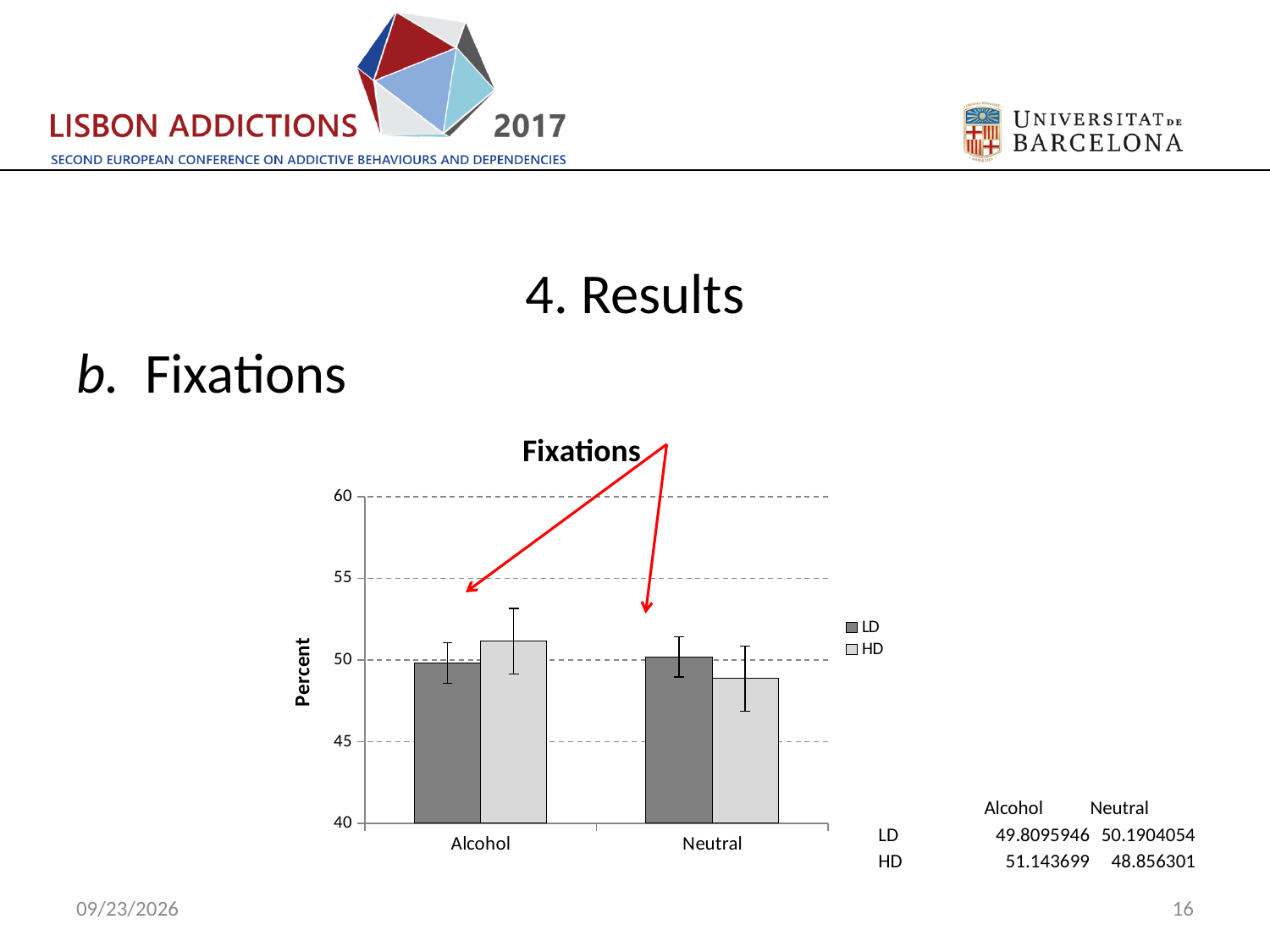
What is the LD value for Neutral in the Fixations chart? 50.1904054 What is the label of the y axis in the Fixations chart? Percent What is the HD value for Neutral in the Fixations chart? 48.856301 What kind of chart is shown under the title "Fixations"? bar chart Is the HD value for Neutral in the Fixations chart greater or less than 50? less What is the HD value for Alcohol in the Fixations chart? 51.143699 Is the HD value for Alcohol in the Fixations chart greater or less than 50? greater How many categories are shown on the x axis of the Fixations chart? 2 What is the LD value for Alcohol in the Fixations chart? 49.8095946 In the Fixations chart, which series has the higher value for Alcohol, LD or HD? HD In the Fixations chart, which series has the higher value for Neutral, LD or HD? LD How many series does the legend of the Fixations chart list? 2